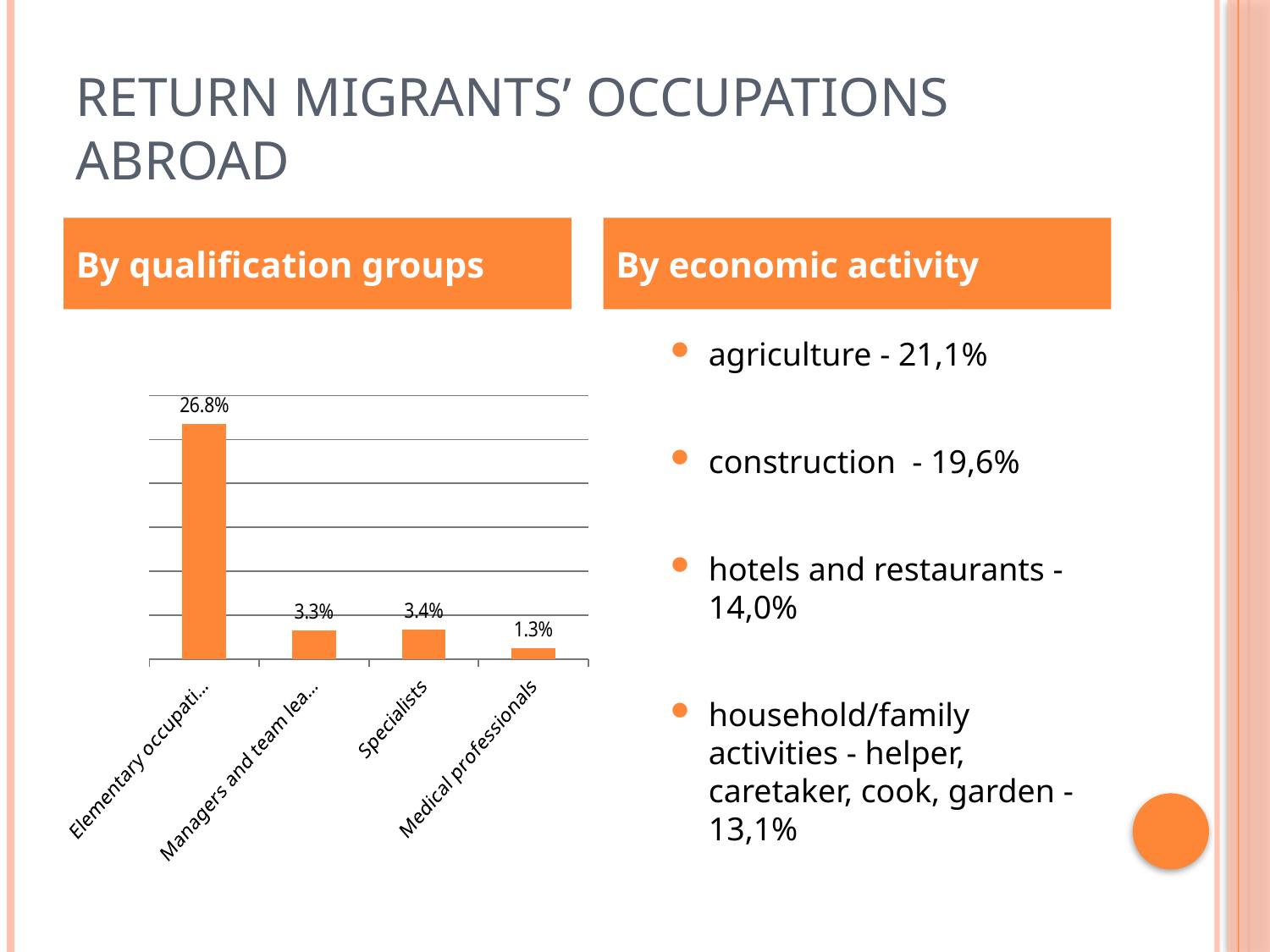
How many categories are plotted in the bar chart? 4 What is the difference between the highest bar (26.8%) and Medical professionals (1.3%) in the bar chart? 25.5% In the bar chart, which is larger: Specialists or Medical professionals? Specialists What colour are the bars in the chart? orange What type of chart is shown under "By qualification groups"? bar chart What is the value for Specialists in the bar chart? 3.4% Which category has the highest value in the bar chart? Elementary occupati… What is the difference between Specialists and Medical professionals in the bar chart? 2.1% What is the value of the leftmost bar (Elementary occupati…) in the bar chart? 26.8% Which category has the lowest value in the bar chart? Medical professionals What is the value for Medical professionals in the bar chart? 1.3% What is the value of the second bar (Managers and team lea…) in the bar chart? 3.3%